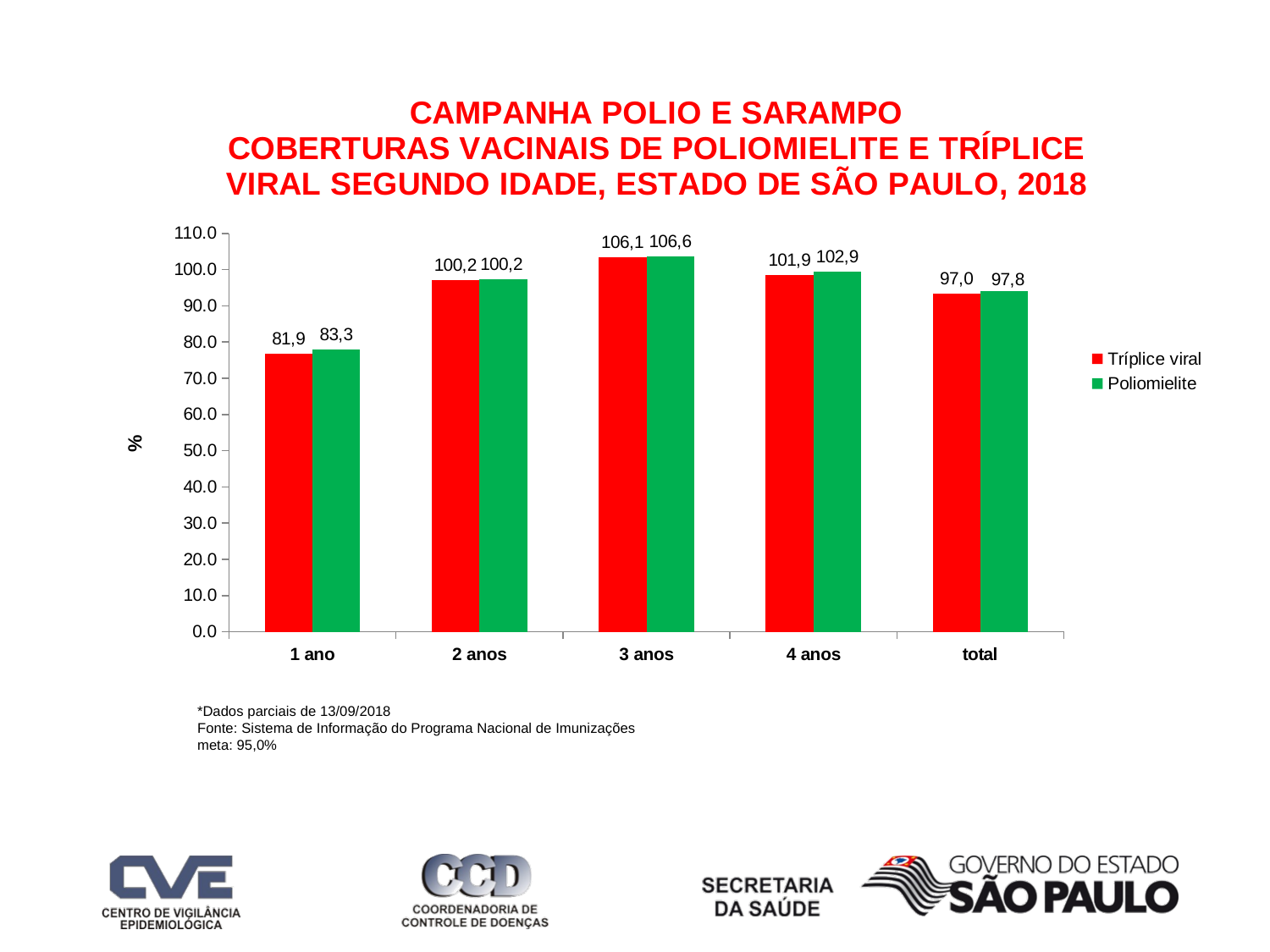
How many age categories are shown on the x axis? 5 What kind of chart is shown on the slide? bar chart Which colour represents Poliomielite in the chart? green Which age category has the highest Tríplice viral value? 3 anos What is the difference between the Poliomielite and Tríplice viral values for 1 ano? 1,4 Is the Tríplice viral value for 1 ano greater or less than 90.0? less What is the Poliomielite value for 4 anos? 102,9 What is the Tríplice viral value for 1 ano? 81,9 What is the Poliomielite value for total? 97,8 Which is larger for 4 anos, Tríplice viral or Poliomielite? Poliomielite Which age category has the lowest Poliomielite value? 1 ano How many series does the legend list? 2